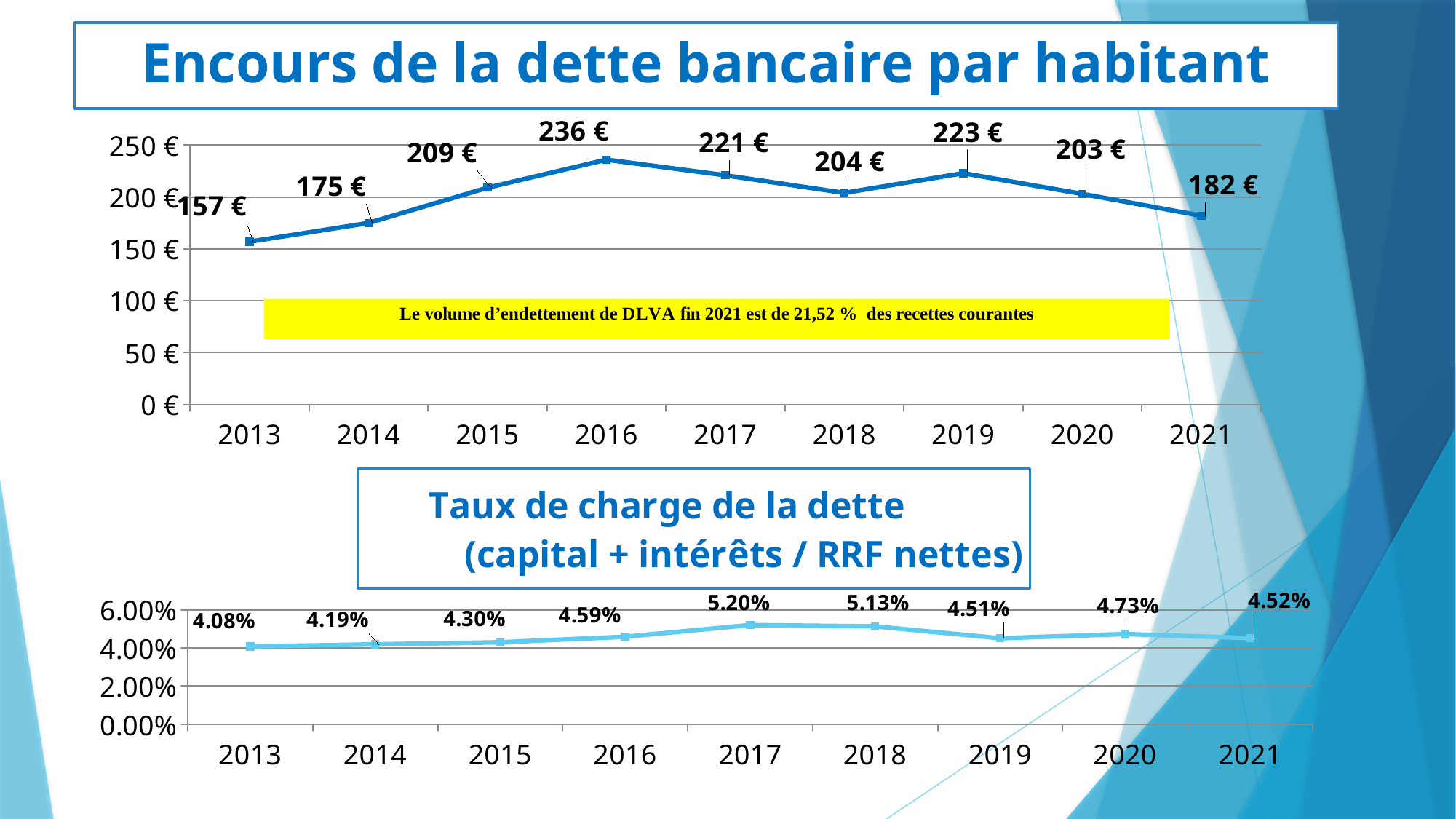
In the 'Taux de charge de la dette' chart, what is the difference between the 2020 value and the 2019 value? 0.22% In the 'Encours de la dette bancaire par habitant' chart, how many years are plotted? 9 What kind of chart is the 'Taux de charge de la dette' chart? line chart In the 'Encours de la dette bancaire par habitant' chart, what is the difference between the 2016 value and the 2021 value? 54 € In the 'Taux de charge de la dette' chart, what is the value for 2017? 5.20% In the 'Taux de charge de la dette' chart, which year has the lowest value? 2013 In the 'Encours de la dette bancaire par habitant' chart, which year has the highest value? 2016 In the 'Encours de la dette bancaire par habitant' chart, which is larger, the value for 2017 or the value for 2018? 2017 In the 'Encours de la dette bancaire par habitant' chart, which year has the lowest value? 2013 In the 'Encours de la dette bancaire par habitant' chart, what is the value for 2016? 236 € In the 'Encours de la dette bancaire par habitant' chart, what is the value for 2013? 157 € In the 'Taux de charge de la dette' chart, do the values rise or fall from 2013 to 2017? rise